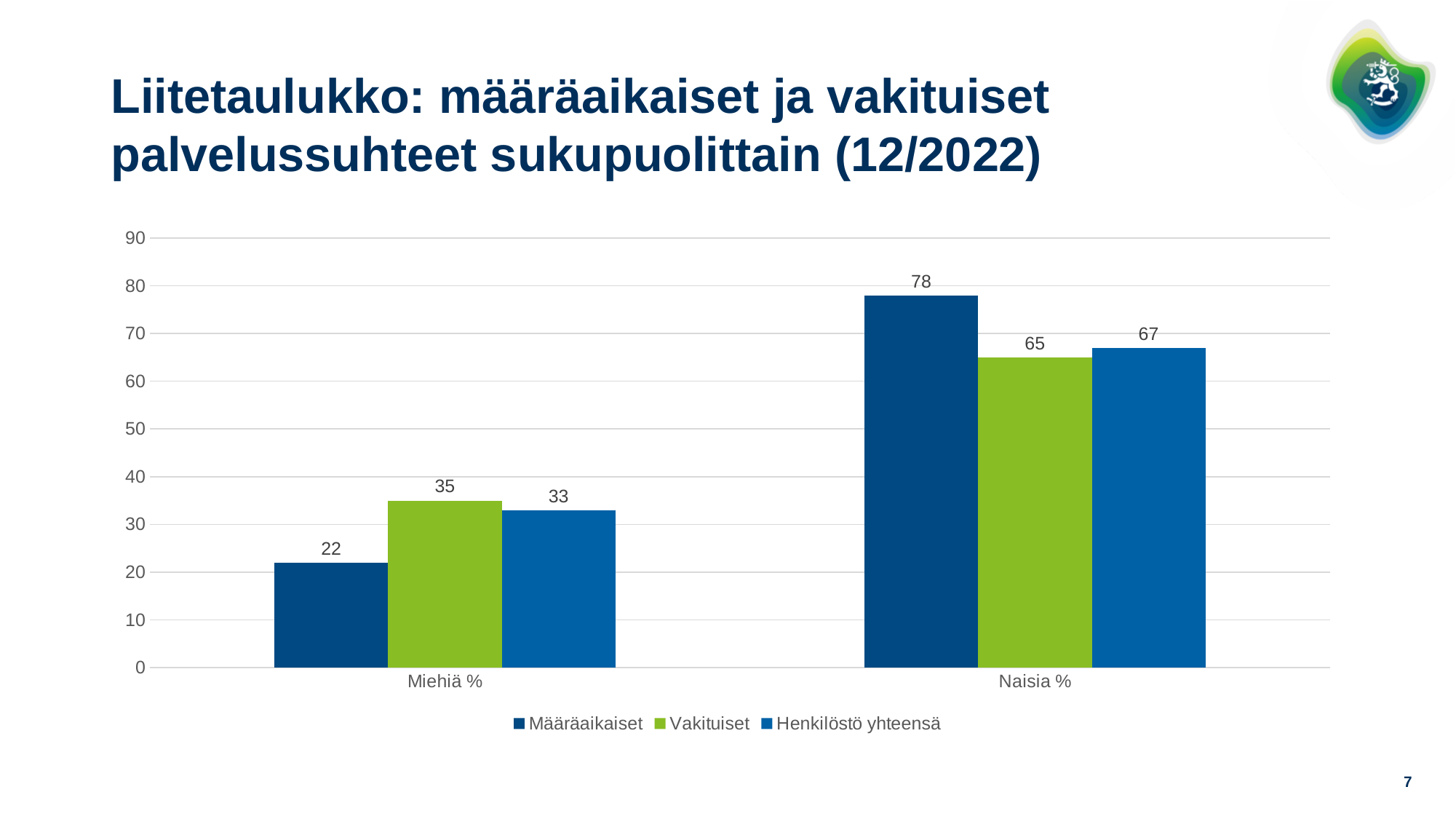
What is the value for Vakituiset in the Naisia % category? 65 What kind of chart is shown on the slide? Bar chart What is the difference between the Määräaikaiset values for Naisia % and Miehiä %? 56 How many categories are shown on the x axis? 2 What is the value for Määräaikaiset in the Miehiä % category? 22 Is the value for Henkilöstö yhteensä in the Naisia % category greater or less than 60? greater Which series has the lowest value in the Miehiä % category? Määräaikaiset How many series does the legend list? 3 What is the value for Henkilöstö yhteensä in the Miehiä % category? 33 What is the value for Määräaikaiset in the Naisia % category? 78 Which is larger: Vakituiset for Miehiä % or Henkilöstö yhteensä for Miehiä %? Vakituiset for Miehiä % Which series has the highest value in the Naisia % category? Määräaikaiset